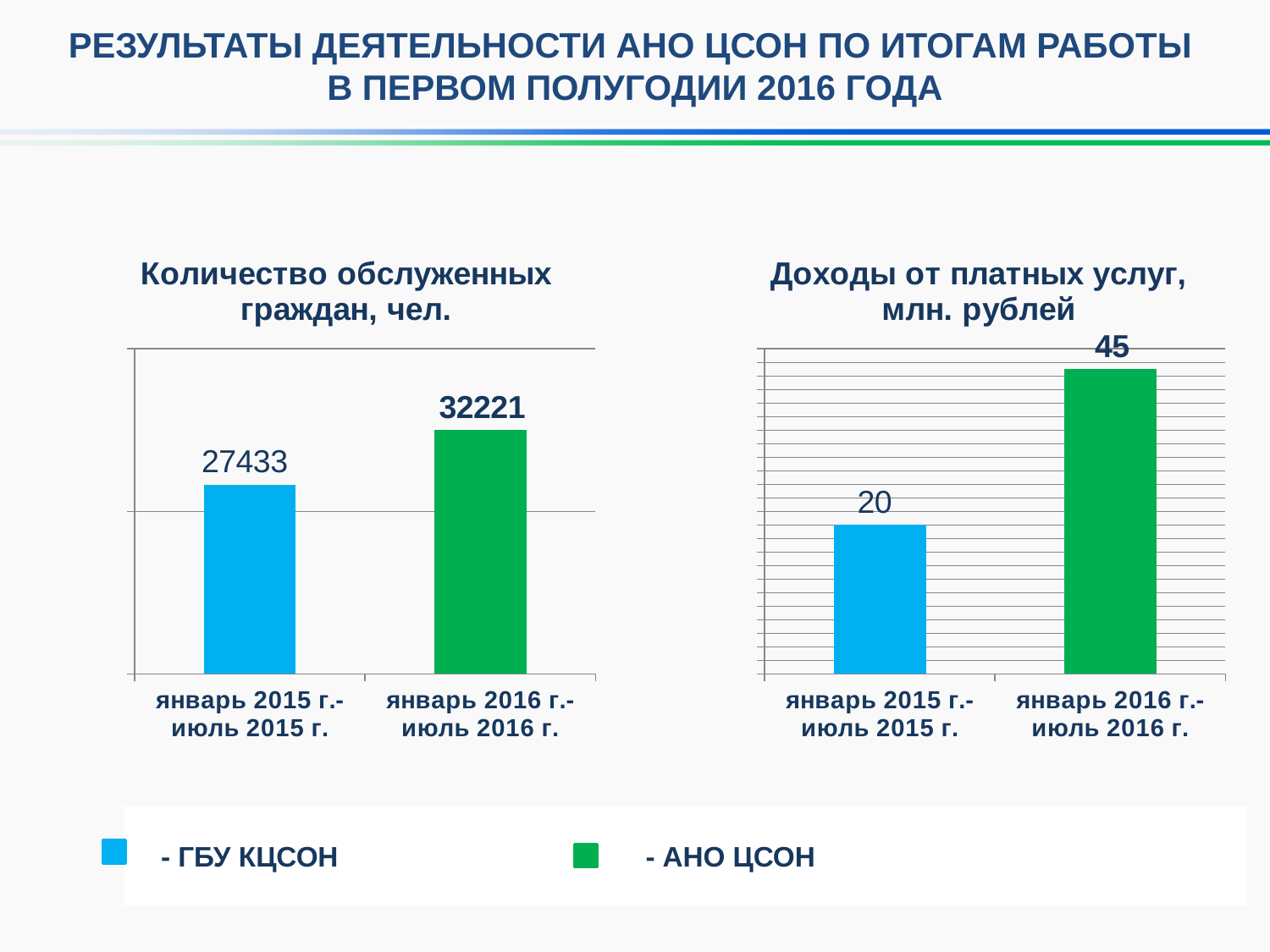
What type of chart is 'Доходы от платных услуг, млн. рублей'? bar chart In the chart 'Доходы от платных услуг, млн. рублей', what is the value for январь 2016 г.-июль 2016 г.? 45 How many categories are shown in the chart 'Количество обслуженных граждан, чел.'? 2 In the chart 'Доходы от платных услуг, млн. рублей', is the value for январь 2016 г.-июль 2016 г. larger or smaller than the value for январь 2015 г.-июль 2015 г.? larger In the chart 'Доходы от платных услуг, млн. рублей', which period has the lower value? январь 2015 г.-июль 2015 г. In the chart 'Количество обслуженных граждан, чел.', what is the difference between the 2016 and 2015 values? 4788 In the chart 'Количество обслуженных граждан, чел.', which period has the higher value? январь 2016 г.-июль 2016 г. In the chart 'Количество обслуженных граждан, чел.', what is the value for январь 2016 г.-июль 2016 г.? 32221 In the chart 'Доходы от платных услуг, млн. рублей', what is the difference between the 2016 and 2015 values? 25 According to the legend at the bottom of the slide, which organisation does the green colour represent? АНО ЦСОН In the chart 'Количество обслуженных граждан, чел.', what is the value for январь 2015 г.-июль 2015 г.? 27433 In the chart 'Доходы от платных услуг, млн. рублей', what is the value for январь 2015 г.-июль 2015 г.? 20